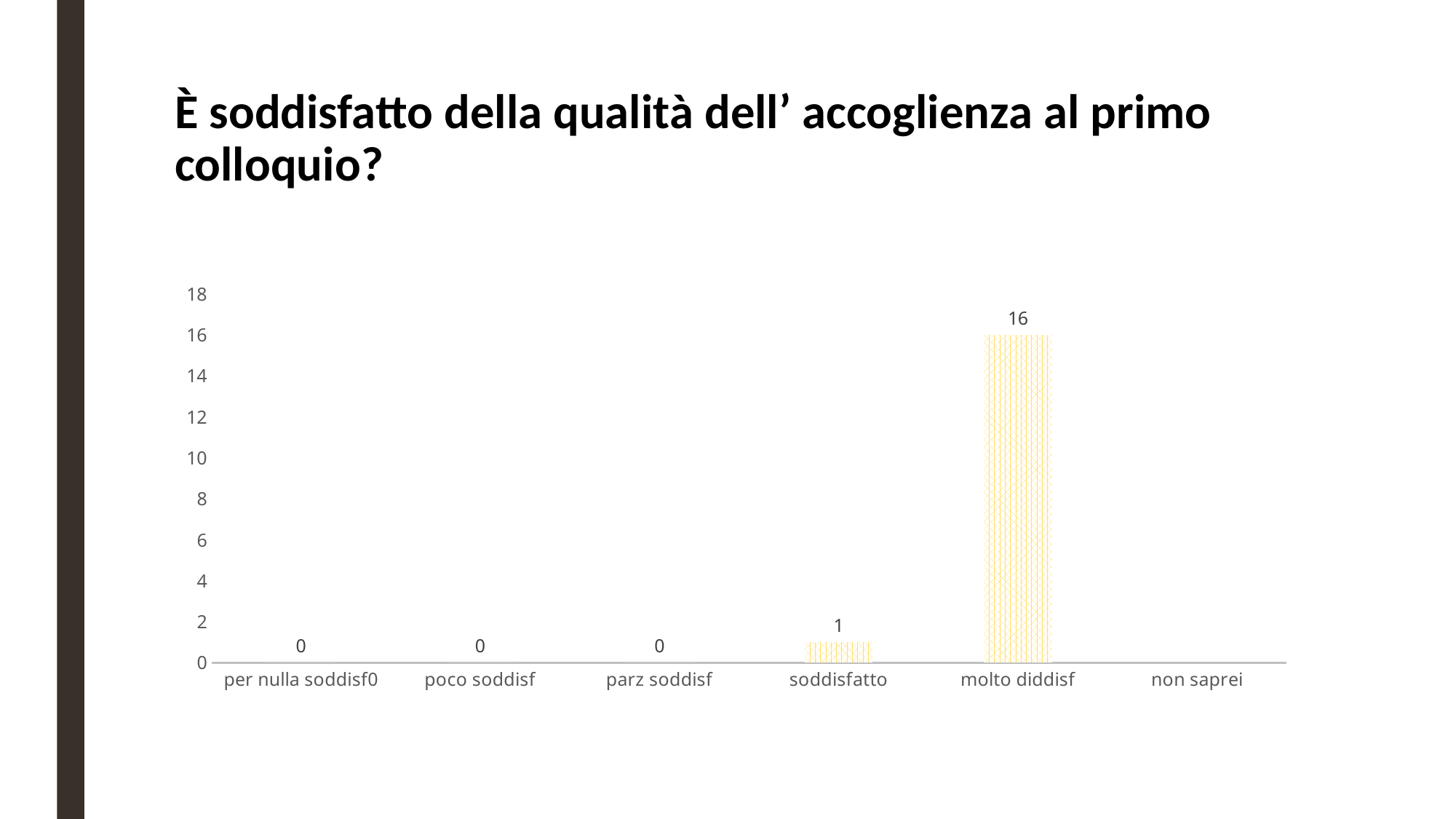
Is the value for "molto diddisf" greater or less than 10? greater What is the highest value shown on the vertical axis? 18 What is the title of the slide containing the chart? È soddisfatto della qualità dell' accoglienza al primo colloquio? What is the value for "parz soddisf"? 0 What is the difference between the values for "molto diddisf" and "soddisfatto"? 15 Which category has the highest value? molto diddisf How many categories are shown on the x axis? 6 What is the value for "poco soddisf"? 0 What is the value for "molto diddisf"? 16 What is the value for "soddisfatto"? 1 Which is larger, the value for "soddisfatto" or the value for "molto diddisf"? molto diddisf What kind of chart is shown on the slide? bar chart